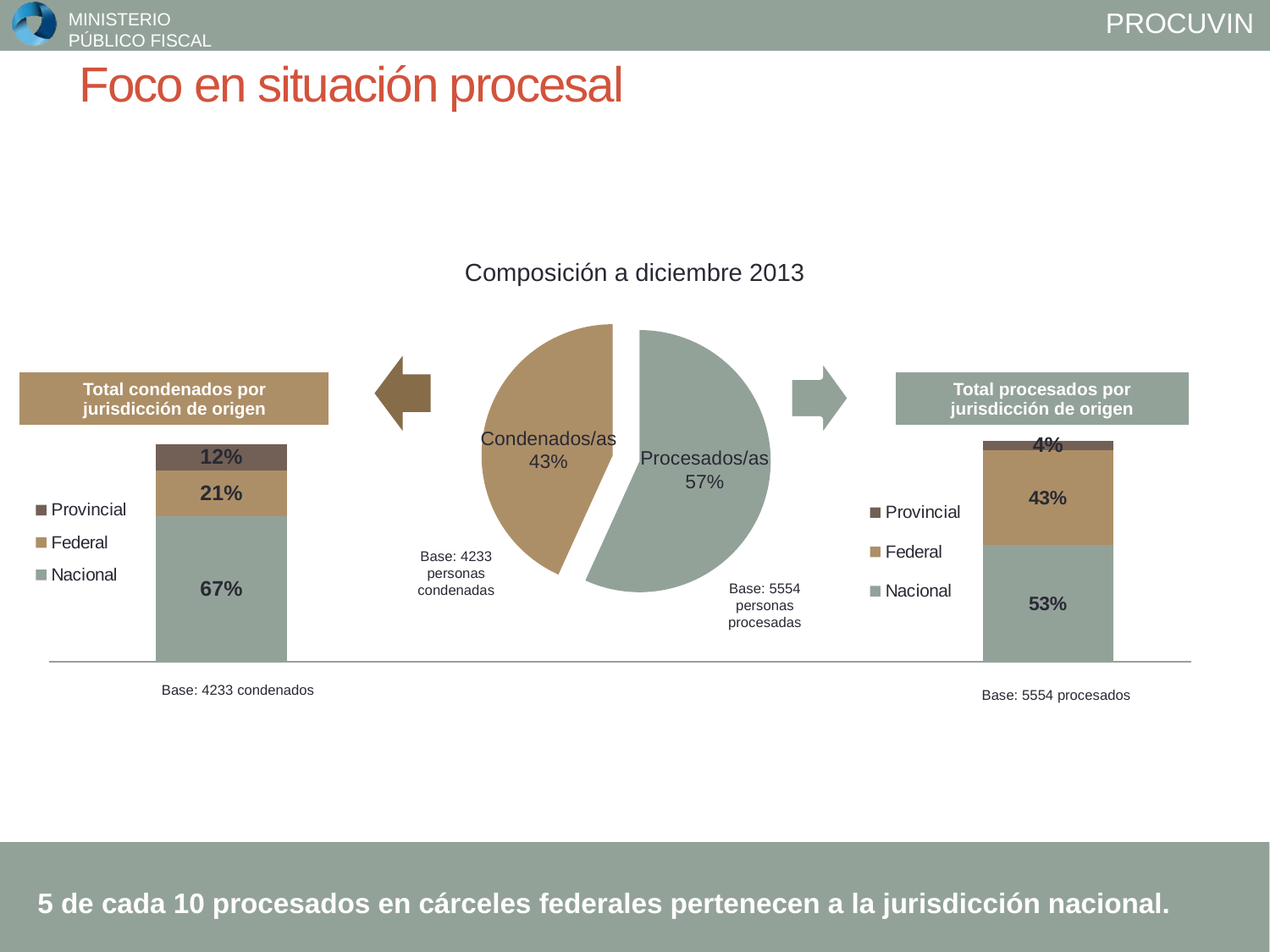
In the pie chart 'Composición a diciembre 2013', what share is Condenados/as? 43% In the chart 'Total condenados por jurisdicción de origen', which jurisdiction has the lowest value? Provincial In the chart 'Total procesados por jurisdicción de origen', which jurisdiction has the highest value? Nacional In the chart 'Total condenados por jurisdicción de origen', what is the difference between Nacional and Federal? 46% In the chart 'Total procesados por jurisdicción de origen', what is the value for Federal? 43% What kind of chart is the one in the centre of the slide titled 'Composición a diciembre 2013'? Pie chart In the chart 'Total procesados por jurisdicción de origen', what is the difference between Nacional and Federal? 10% In the chart 'Total condenados por jurisdicción de origen', what is the value for Provincial? 12% In the pie chart 'Composición a diciembre 2013', what share is Procesados/as? 57% How many series does the legend of the chart 'Total procesados por jurisdicción de origen' list? 3 In the chart 'Total condenados por jurisdicción de origen', what is the value for Nacional? 67% In the pie chart 'Composición a diciembre 2013', which slice is larger, Condenados/as or Procesados/as? Procesados/as